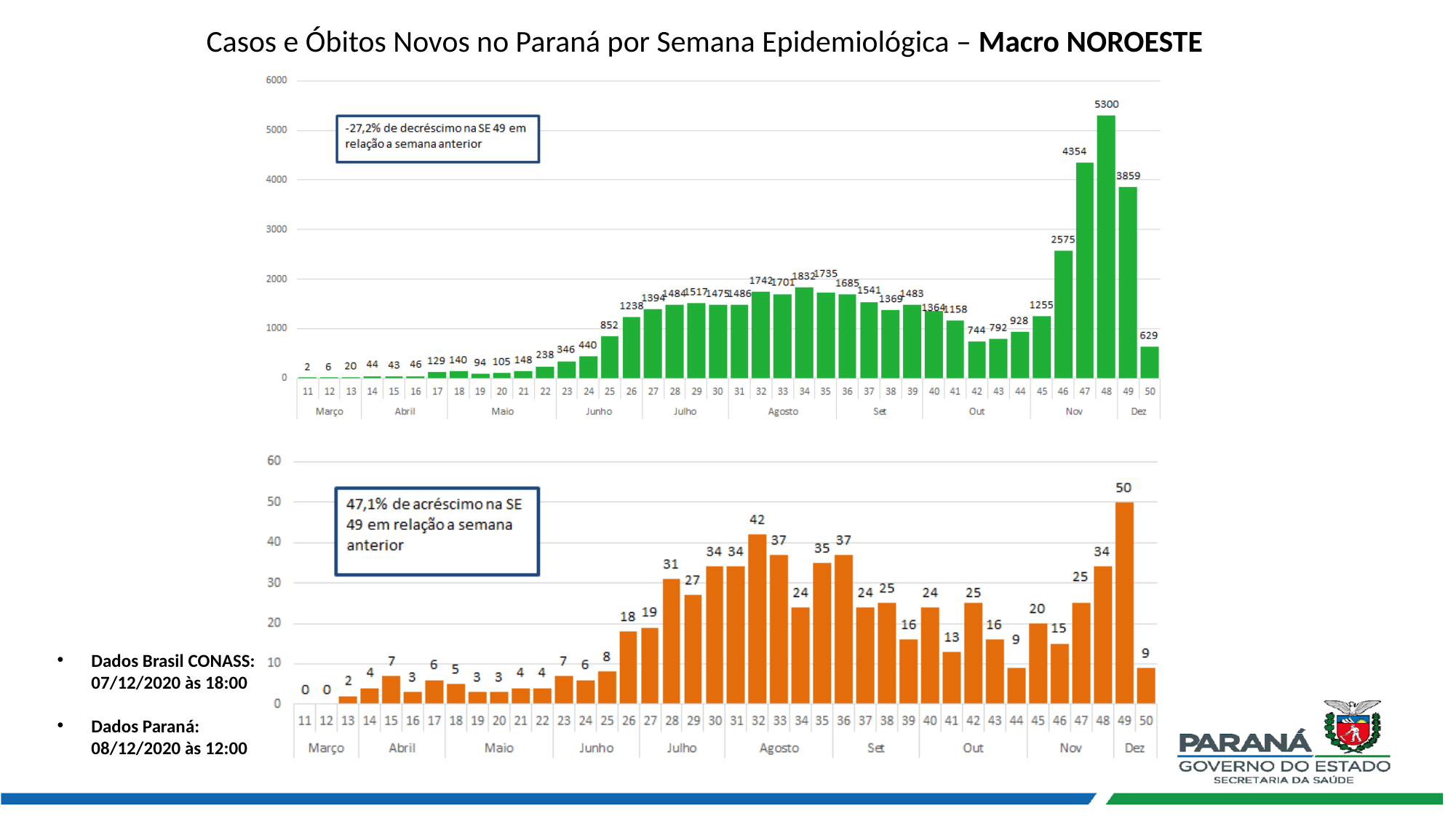
In the top chart (green bars), what is the value for week 48? 5300 In the bottom chart (orange bars), what is the difference between the values for week 49 and week 50? 41 In the bottom chart (orange bars), what is the value for week 49? 50 In the top chart (green bars), what is the difference between the values for week 48 and week 49? 1441 In the top chart (green bars), which week has the highest value? 48 What kind of chart is the top chart? bar chart In the top chart (green bars), do the values rise or fall from week 48 to week 50? fall How many weeks (categories) are shown on the x axis of the bottom chart? 40 In the bottom chart (orange bars), which week has the highest value? 49 In the top chart (green bars), what is the value for week 50? 629 In the bottom chart (orange bars), what is the value for week 32? 42 In the top chart (green bars), which is larger, the value for week 46 or the value for week 45? week 46